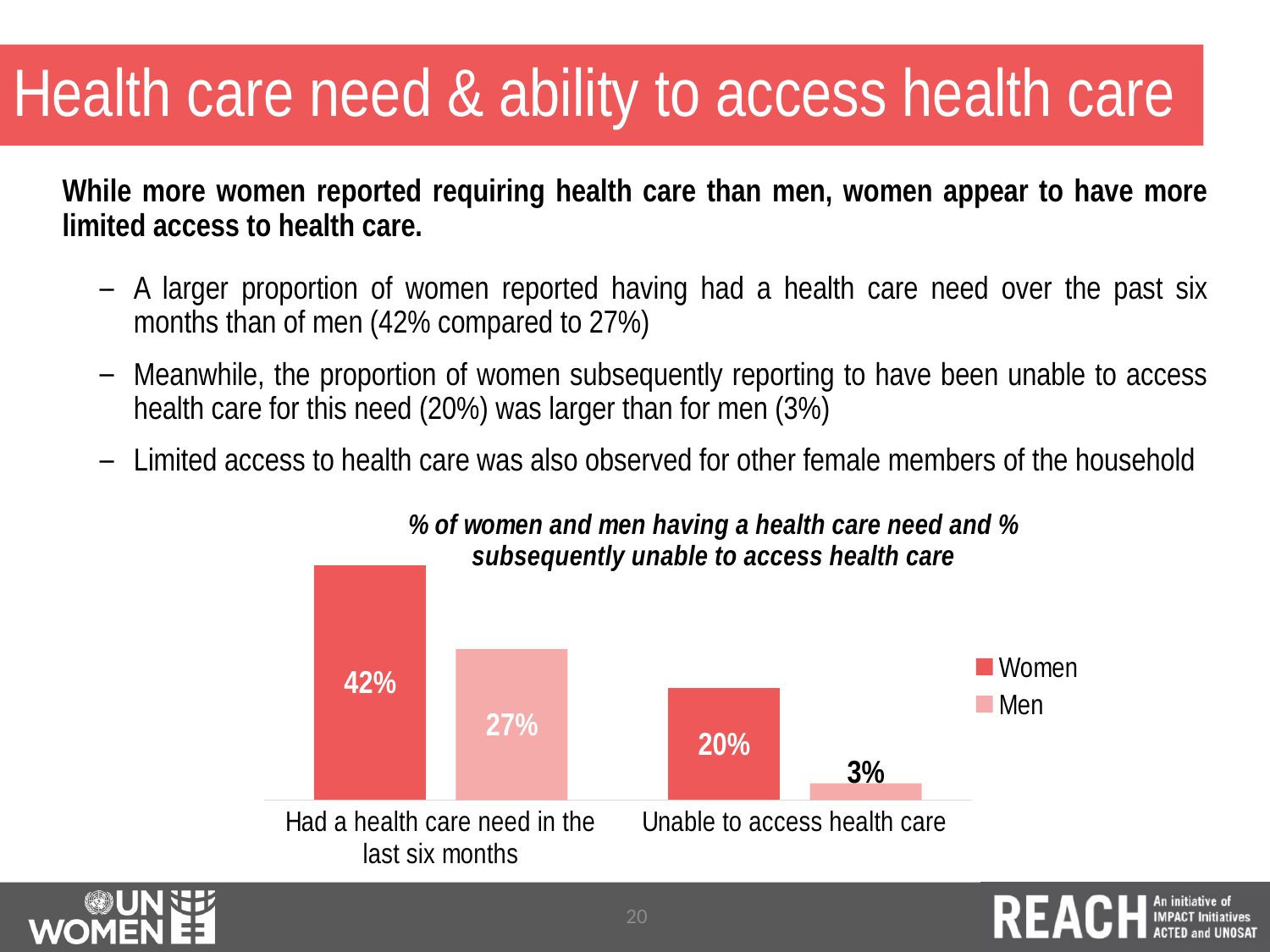
How many categories are shown on the x axis of the chart? 2 What percentage of men were unable to access health care? 3% What percentage of women had a health care need in the last six months? 42% What percentage of men had a health care need in the last six months? 27% How many series does the chart legend list? 2 Which series has the highest value in the chart? Women What is the difference between women and men for 'Unable to access health care'? 17% What type of chart is shown on the slide? Bar chart For 'Unable to access health care', which is larger: the value for women or for men? Women What is the difference between women and men for 'Had a health care need in the last six months'? 15% Which bar shows the lowest value in the chart? Men, Unable to access health care What percentage of women were unable to access health care? 20%